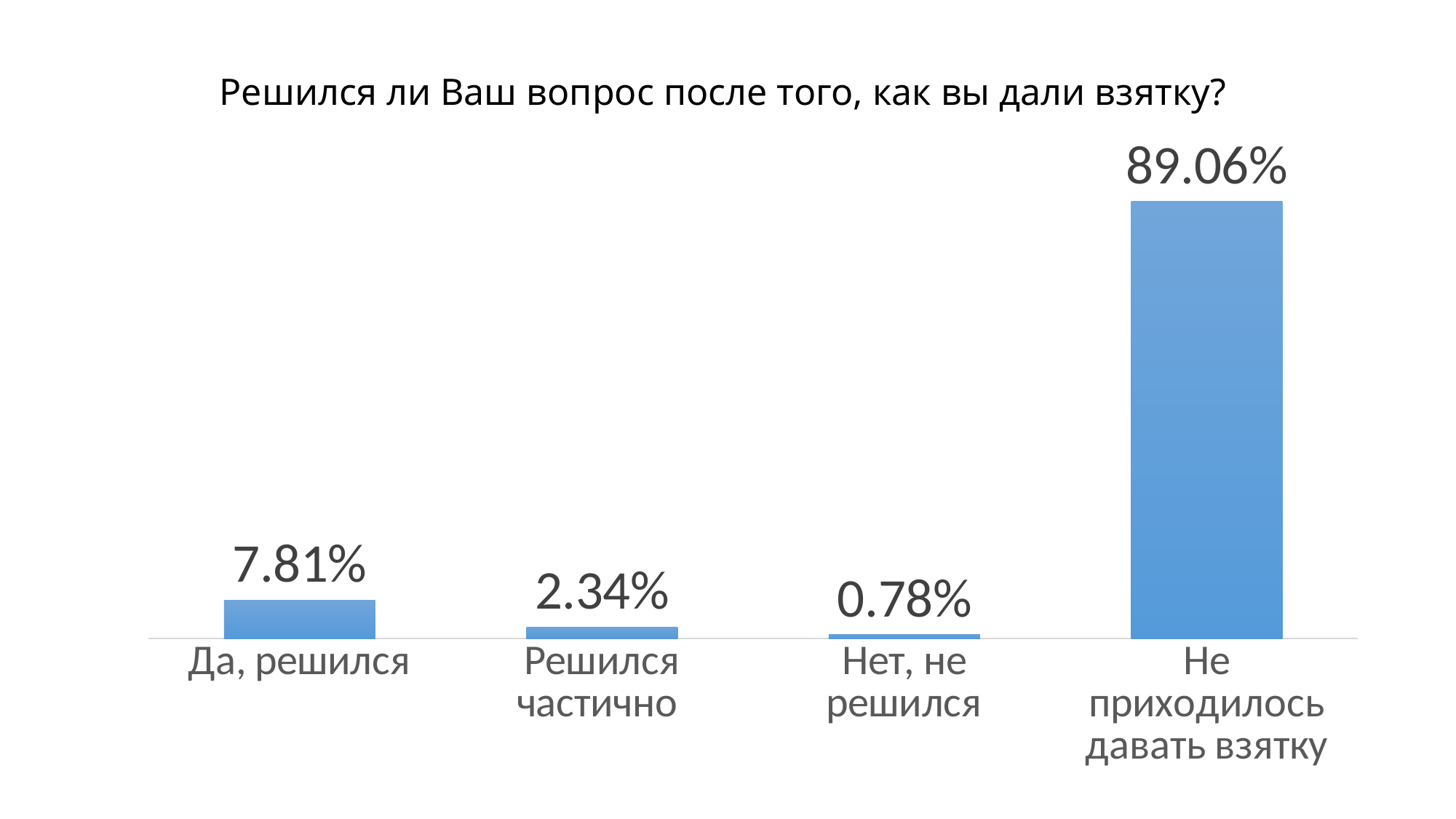
What kind of chart is shown on the slide? Bar chart How many categories are shown in the chart? 4 What is the difference between the values for "Не приходилось давать взятку" and "Да, решился"? 81.25% Which is larger, the value for "Решился частично" or the value for "Нет, не решился"? Решился частично What is the value for "Не приходилось давать взятку"? 89.06% What is the value for "Да, решился"? 7.81% What is the difference between the values for "Да, решился" and "Решился частично"? 5.47% What is the title of the chart? Решился ли Ваш вопрос после того, как вы дали взятку? Which category has the highest value? Не приходилось давать взятку Which category has the lowest value? Нет, не решился What is the value for "Решился частично"? 2.34% What is the value for "Нет, не решился"? 0.78%